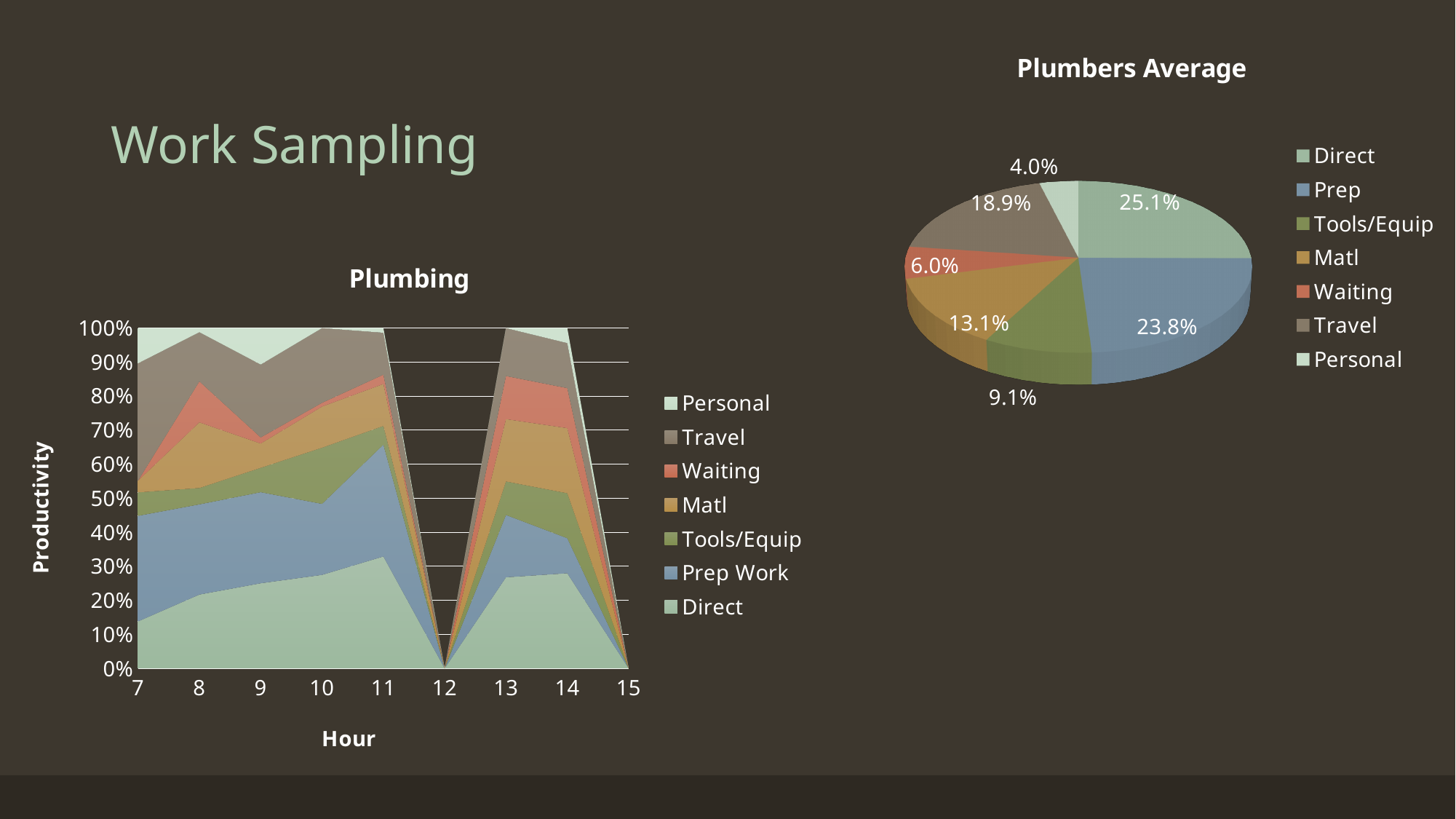
What is the x-axis title of the Plumbing chart? Hour How many slices does the Plumbers Average pie chart have? 7 In the Plumbers Average pie chart, which category has the largest share? Direct In the Plumbers Average pie chart, what is the difference between the Direct and Prep shares? 1.3% In the Plumbers Average pie chart, which is larger, Matl or Tools/Equip? Matl In the Plumbers Average pie chart, what share is Waiting? 6.0% What kind of chart is the Plumbers Average chart? Pie chart How many hours are shown on the x axis of the Plumbing chart? 9 How many series does the legend of the Plumbing chart list? 7 In the Plumbers Average pie chart, which category has the smallest share? Personal In the Plumbers Average pie chart, what share is Direct? 25.1% In the Plumbers Average pie chart, what share is Travel? 18.9%